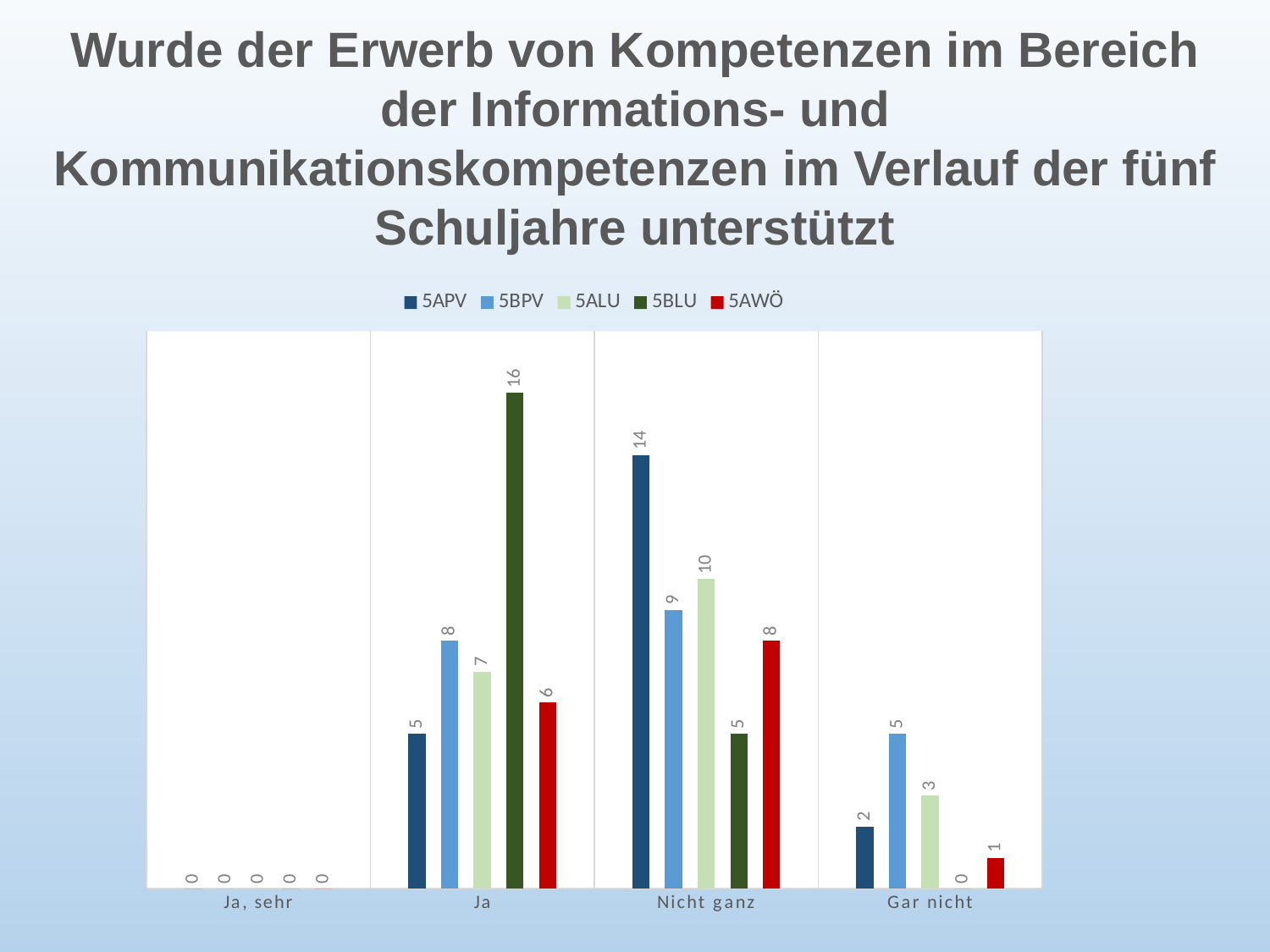
What is the value for 5APV in the 'Nicht ganz' category? 14 What is the value for 5BLU in the 'Ja' category? 16 How many categories are shown on the x axis? 4 Which series has the highest value in the 'Ja' category? 5BLU What is the value for every series in the 'Ja, sehr' category? 0 Which series is shown in red in the legend? 5AWÖ What is the value for 5AWÖ in the 'Gar nicht' category? 1 Which series has the lowest value in the 'Gar nicht' category? 5BLU Which is larger: the 5ALU value for 'Ja' or the 5ALU value for 'Nicht ganz'? Nicht ganz How many series does the legend list? 5 What kind of chart is shown on the slide? bar chart What is the difference between the 5APV and 5BLU values in the 'Nicht ganz' category? 9